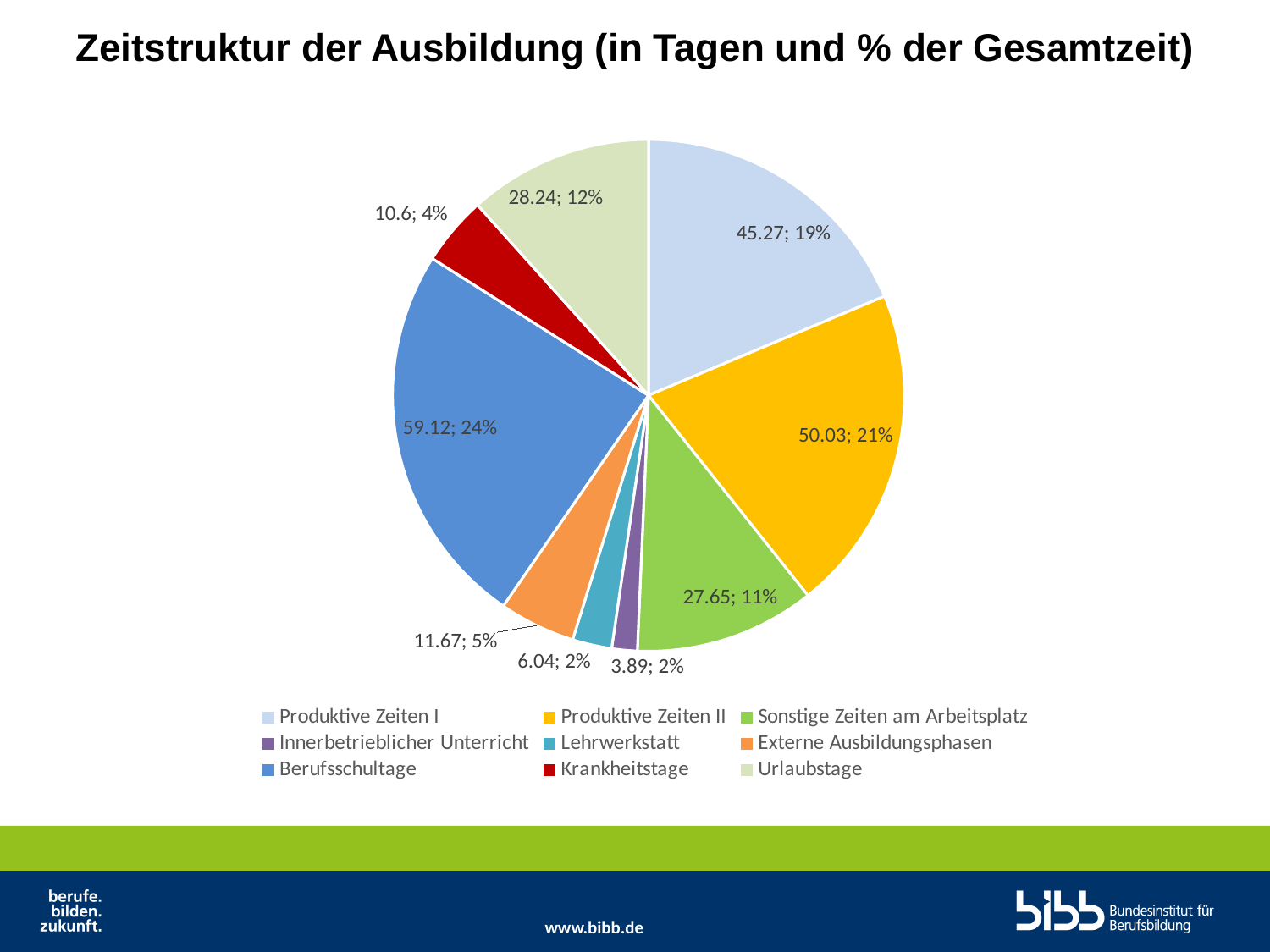
What is the title of the chart? Zeitstruktur der Ausbildung (in Tagen und % der Gesamtzeit) What share of the total time is Produktive Zeiten II? 21% How many days are shown for Sonstige Zeiten am Arbeitsplatz? 27.65 Which has more days, Externe Ausbildungsphasen or Lehrwerkstatt? Externe Ausbildungsphasen What share of the total time is Krankheitstage? 4% How many days are shown for Urlaubstage? 28.24 What is the difference in days between Produktive Zeiten II and Produktive Zeiten I? 4.76 Which category has the largest slice of the pie? Berufsschultage What kind of chart is shown on the slide? pie chart Which category has the smallest slice of the pie? Innerbetrieblicher Unterricht How many categories does the pie chart have? 9 How many days are shown for Berufsschultage? 59.12